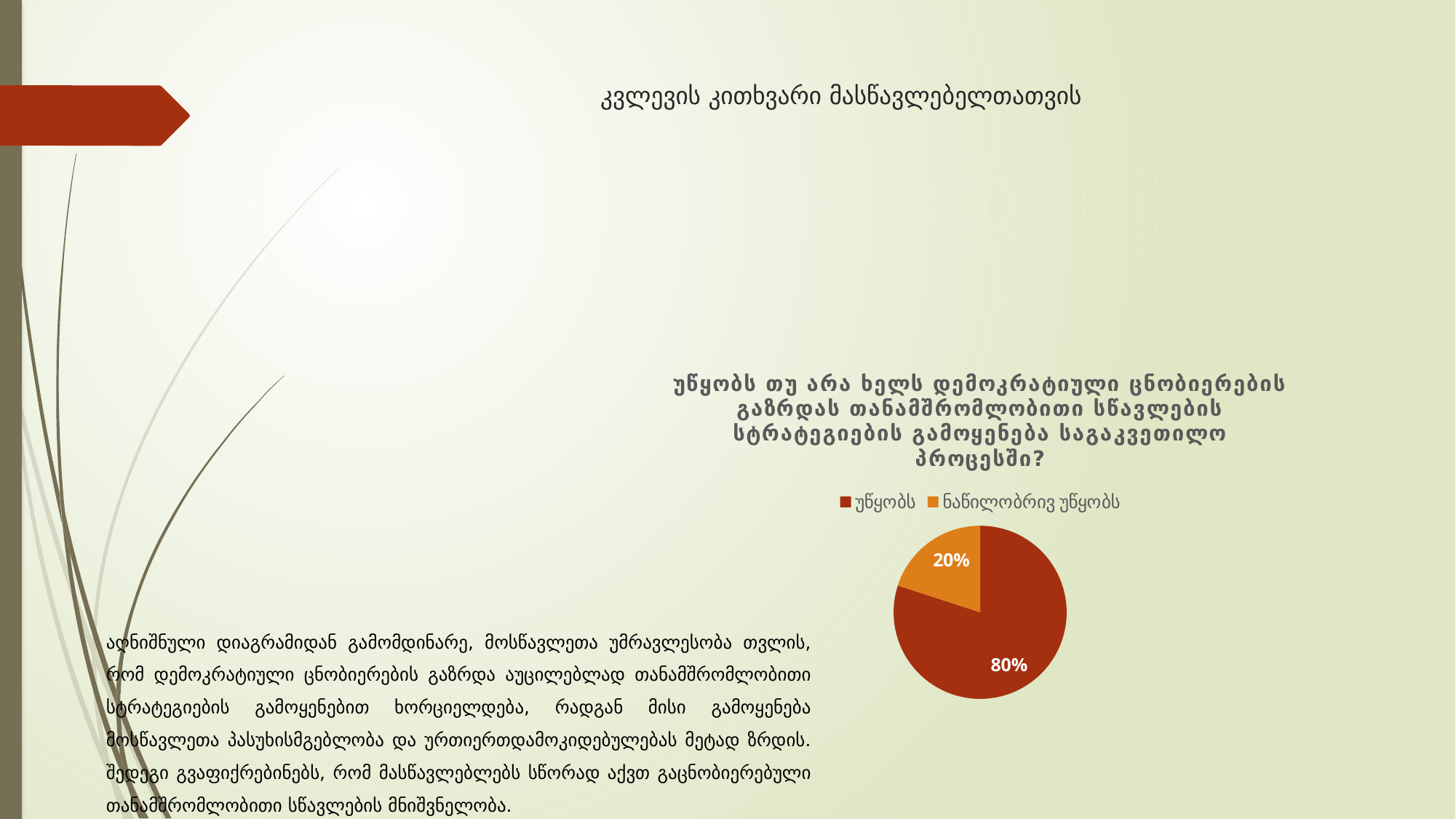
Which category has the smallest slice of the pie? ნაწილობრივ უწყობს How many entries does the legend of the pie chart list? 2 What colour is the slice labelled "უწყობს"? dark red What share of the pie does the slice labelled "ნაწილობრივ უწყობს" represent? 20% Which is larger: the "უწყობს" slice or the "ნაწილობრივ უწყობს" slice? უწყობს What share of the pie does the slice labelled "უწყობს" represent? 80% What colour is the slice labelled "ნაწილობრივ უწყობს"? orange What is the difference in percentage points between the "უწყობს" slice and the "ნაწილობრივ უწყობს" slice? 60 What kind of chart is shown on the slide? pie chart Which category has the largest slice of the pie? უწყობს How many slices does the pie chart have? 2